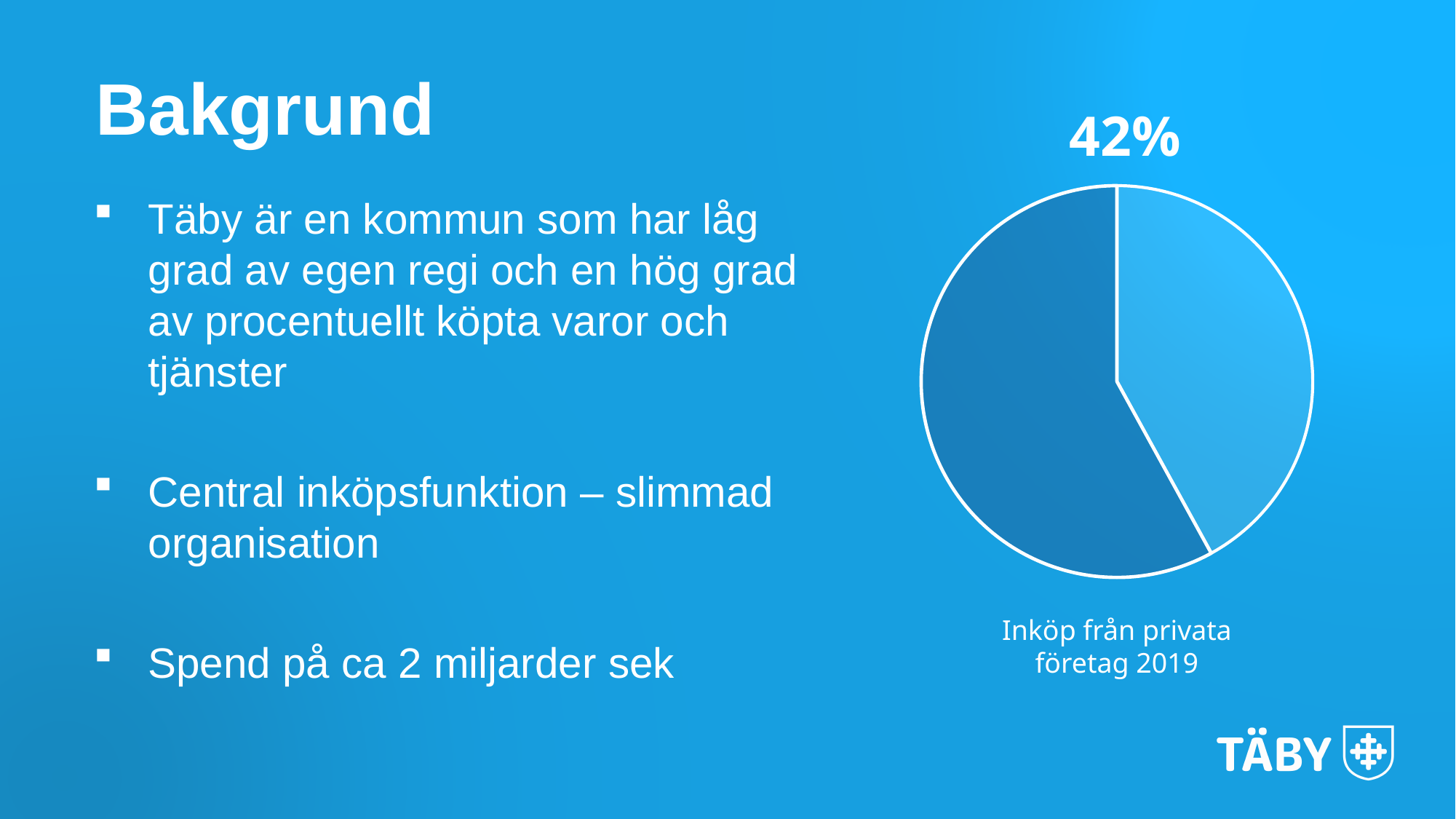
What percentage is printed on the pie chart? 42% How many slices does the pie chart have? 2 What is the caption printed below the pie chart? Inköp från privata företag 2019 What kind of chart is shown on the slide? pie chart Which year does the pie chart caption refer to? 2019 Which slice of the pie chart is larger, the lighter slice labelled 42% or the darker unlabelled slice? the darker unlabelled slice Is the slice labelled 42% greater or less than half of the pie? less